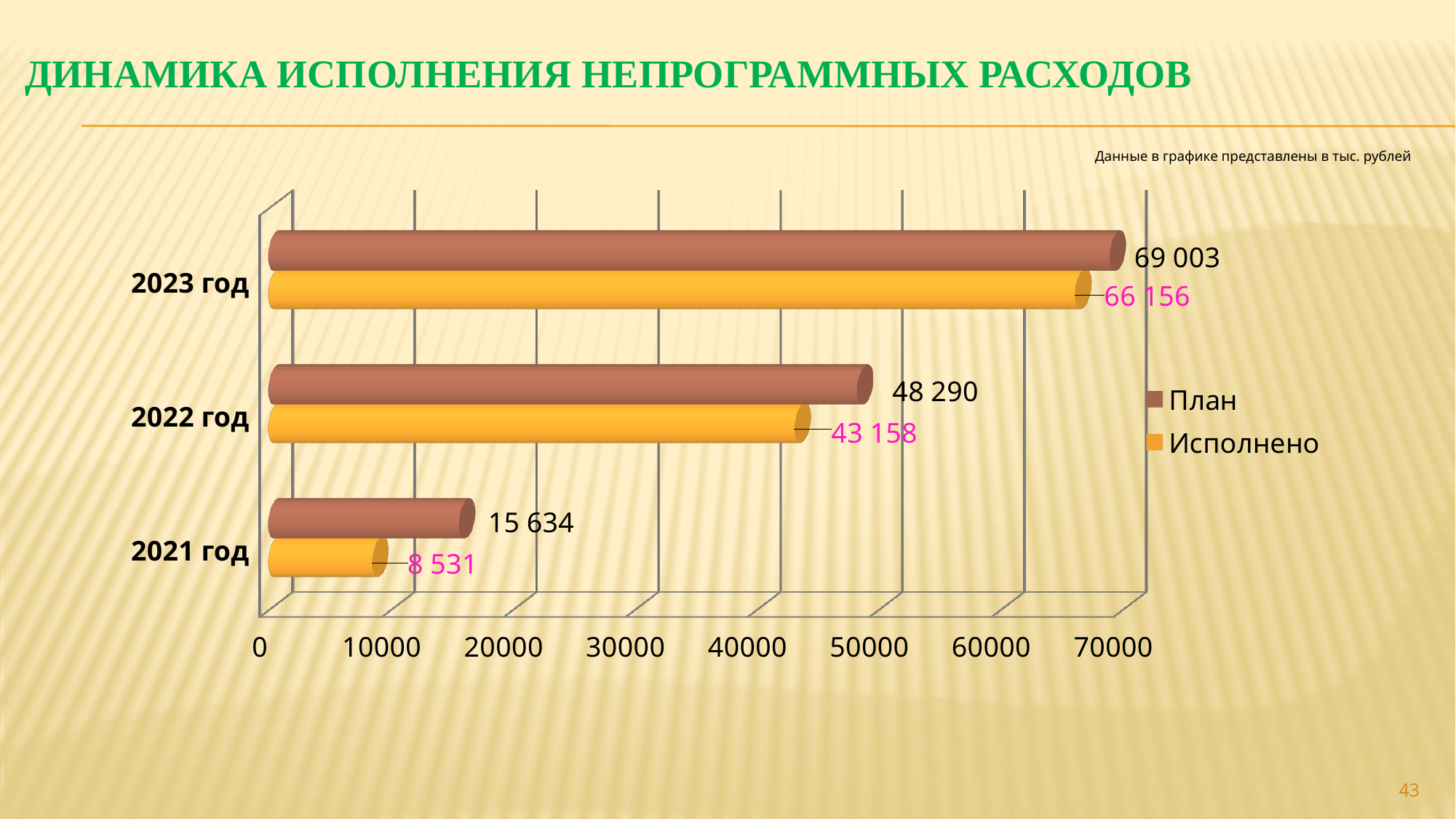
How many series does the legend list? 2 Which year has the highest Исполнено value? 2023 год What is the Исполнено value for 2022 год? 43 158 What is the План value for 2021 год? 15 634 What is the difference between the План values for 2023 год and 2022 год? 20 713 What is the difference between План and Исполнено for 2022 год? 5 132 What kind of chart is shown on the slide? Bar chart What is the Исполнено value for 2021 год? 8 531 Which is larger for 2021 год, План or Исполнено? План Which year has the lowest План value? 2021 год How many years are shown on the chart? 3 What is the План value for 2023 год? 69 003